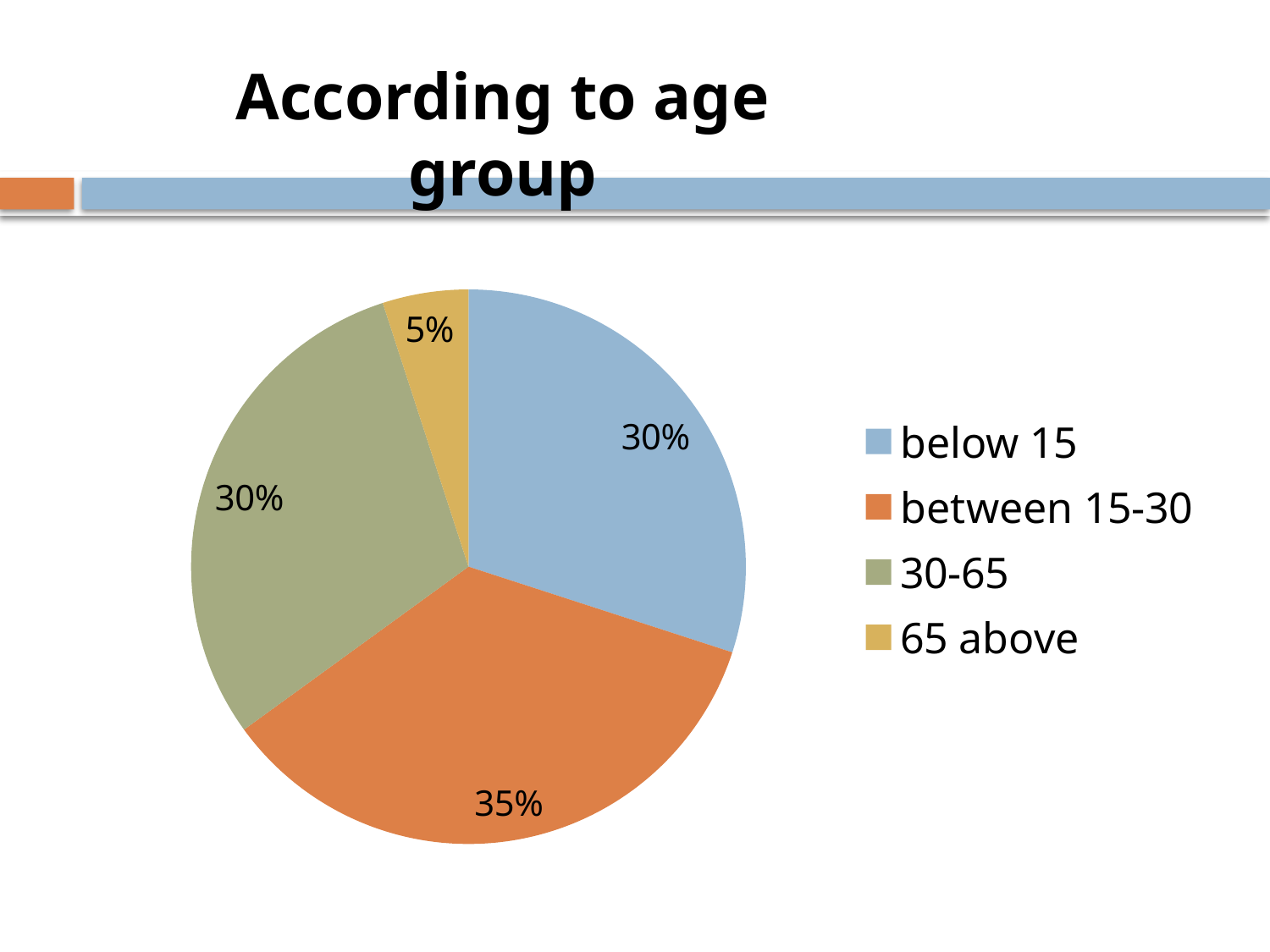
Which age group has the smallest share of the pie? 65 above Which colour represents the '30-65' age group in the legend? green What is the title of the slide containing the pie chart? According to age group What is the value shown for the 'below 15' slice? 30% What is the value shown for the '30-65' slice? 30% What share of the pie does the 'between 15-30' slice represent? 35% How many slices does the pie chart have? 4 Which age group has the largest share of the pie? between 15-30 What kind of chart is shown on the slide? pie chart What is the difference between the shares for 'between 15-30' and '65 above'? 30% Which is larger, the share for 'between 15-30' or the share for 'below 15'? between 15-30 What is the value shown for the '65 above' slice? 5%